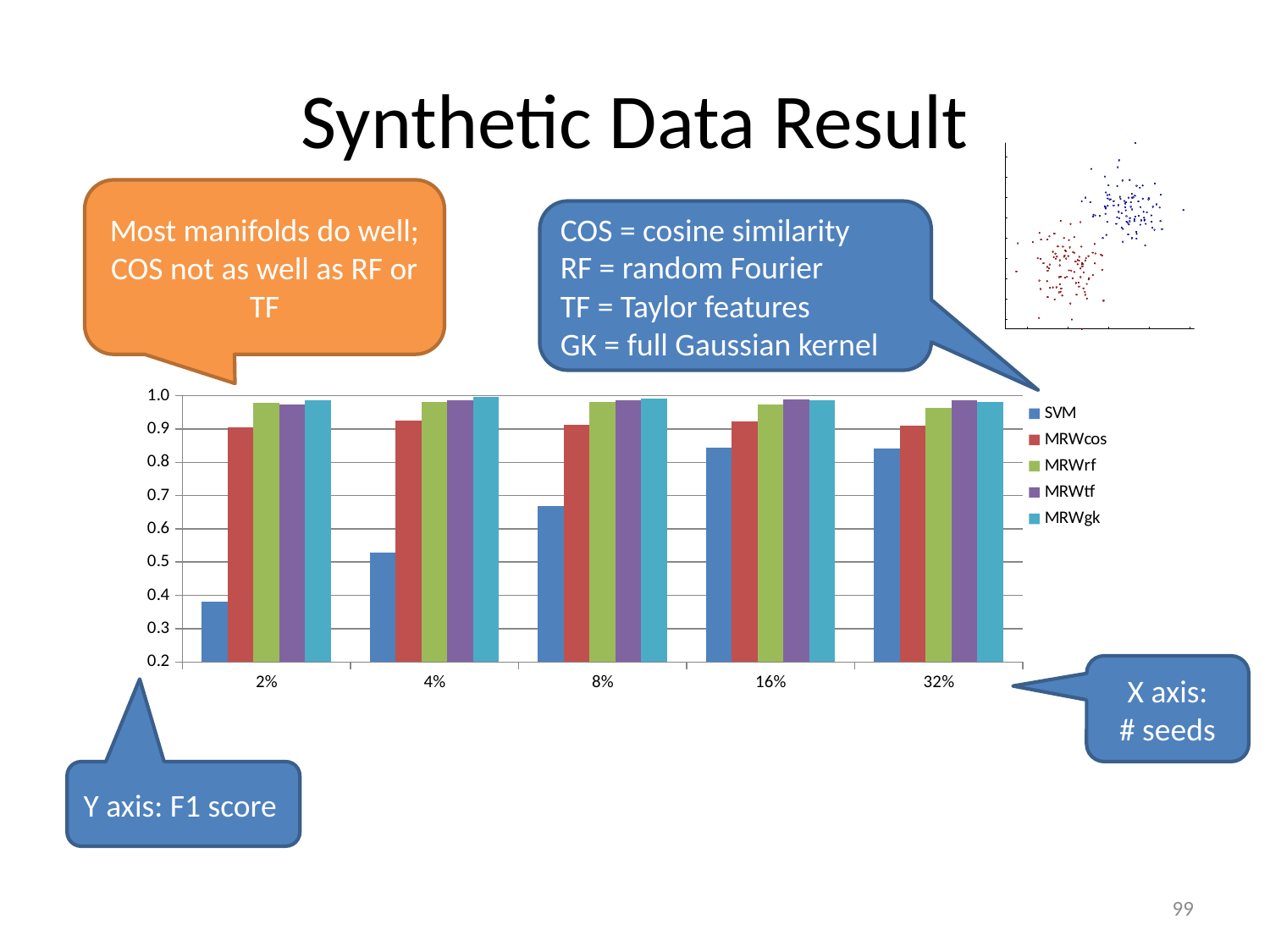
What kind of chart is the main chart on the slide? bar chart In the bar chart, is the MRWcos value at 2% greater or less than 0.8? greater In the bar chart, which is larger at 8%: the MRWcos value or the MRWrf value? MRWrf In the bar chart, is the SVM value at 16% greater or less than 0.8? greater In the bar chart, how many categories are shown on the x axis? 5 In the bar chart, which series has the lowest value at 2%? SVM In the bar chart, is the SVM value at 8% greater or less than 0.6? greater In the bar chart, does the SVM series generally rise or fall as the number of seeds increases from 2% to 32%? rise In the bar chart, how many series does the legend list? 5 According to the slide, what does the y axis of the bar chart represent? F1 score In the bar chart, which series has the lowest value at 8%? SVM